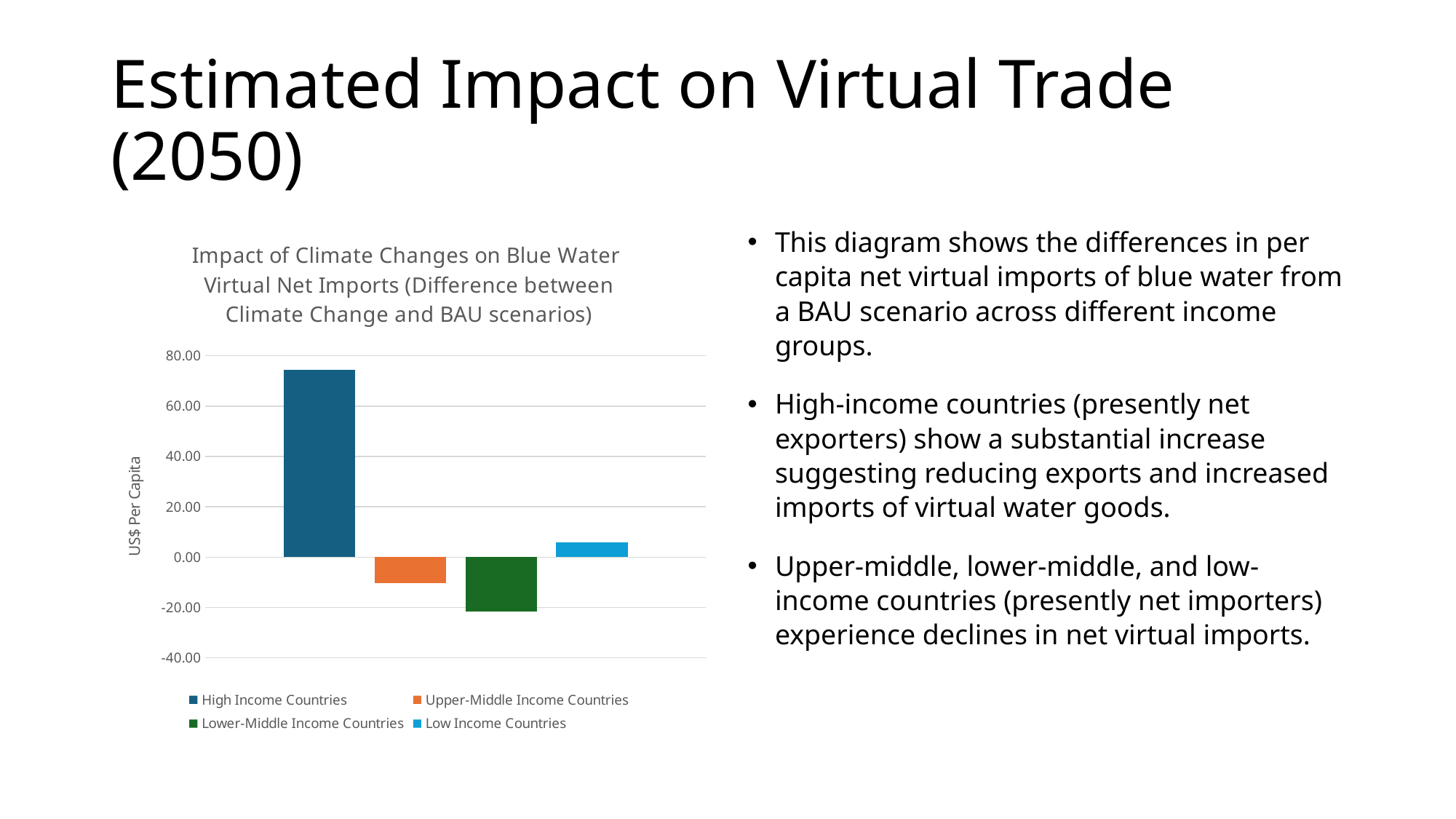
Is the value for High Income Countries greater or less than 60? greater Is the value for Lower-Middle Income Countries greater or less than 0? less Which income group has the highest value in the chart? High Income Countries How many bars are plotted in the chart? 4 Which income group has the lowest value in the chart? Lower-Middle Income Countries Is the value for Low Income Countries greater or less than 20? less What is the label on the chart's vertical axis? US$ Per Capita What colour is the bar for Low Income Countries? light blue Which is larger, the value for Upper-Middle Income Countries or the value for Lower-Middle Income Countries? Upper-Middle Income Countries How many series does the chart's legend list? 4 What kind of chart is shown on the slide? bar chart